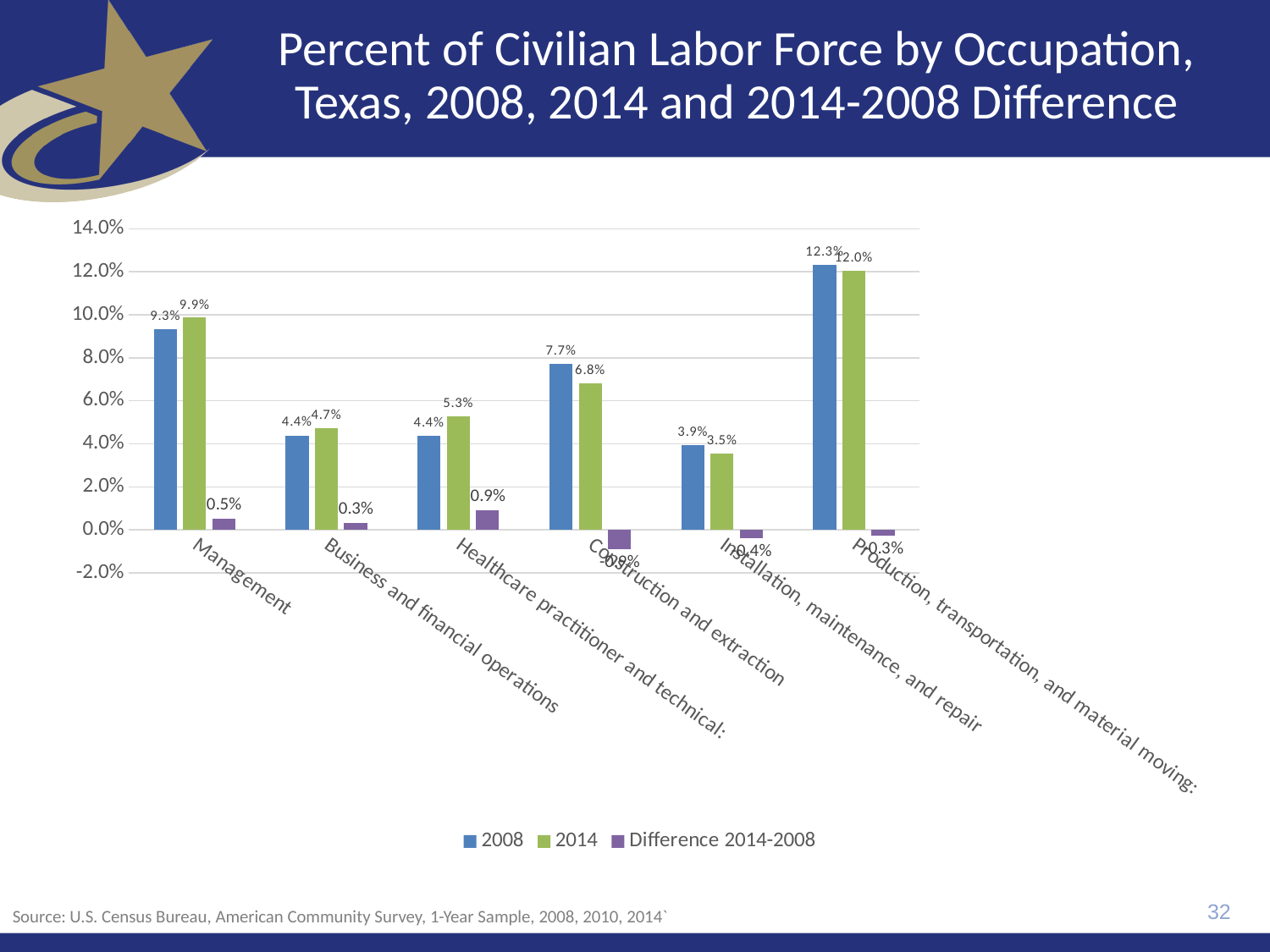
What was the 2014 value for Production, transportation, and material moving? 12.0% Which occupation has the highest 2014 value? Production, transportation, and material moving How much higher is the 2014 value than the 2008 value for Healthcare practitioner and technical? 0.9% Which occupation has the lowest 2008 value? Installation, maintenance, and repair What are the three series listed in the legend? 2008, 2014, Difference 2014-2008 What kind of chart is shown on the slide? Bar chart For Construction and extraction, which year has the larger value, 2008 or 2014? 2008 What was the percent of the civilian labor force in Management in 2008? 9.3% What is the Difference 2014-2008 value shown for Healthcare practitioner and technical? 0.9% How many occupation categories are shown on the x axis? 6 Is the 2014 value for Management greater or less than 8.0%? greater How many series does the legend list? 3